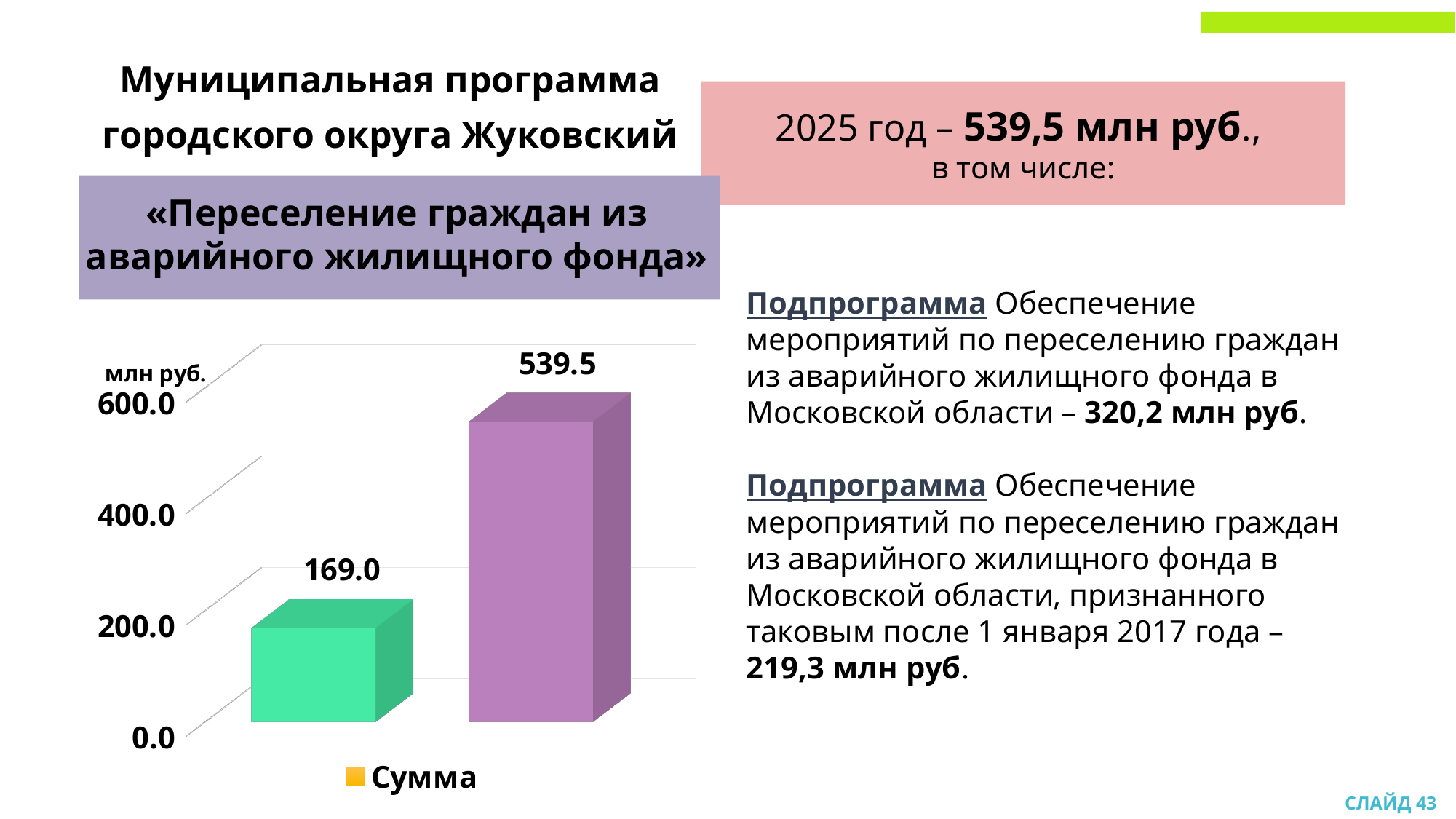
Which bar has the highest value, the left green bar or the right purple bar? the right purple bar What is the difference between the values of the right bar and the left bar? 370.5 Is the value of the left green bar greater or less than 200.0? less Is the value of the right purple bar greater or less than 400.0? greater Is the value of the left green bar larger or smaller than the value of the right purple bar? smaller How many series does the chart legend list? 1 What kind of chart is shown on the slide? bar chart Which bar has the lowest value, the left green bar or the right purple bar? the left green bar What is the name of the series shown in the chart legend? Сумма How many bars are plotted in the chart? 2 What is the value shown on the left (green) bar of the chart? 169.0 What is the value shown on the right (purple) bar of the chart? 539.5